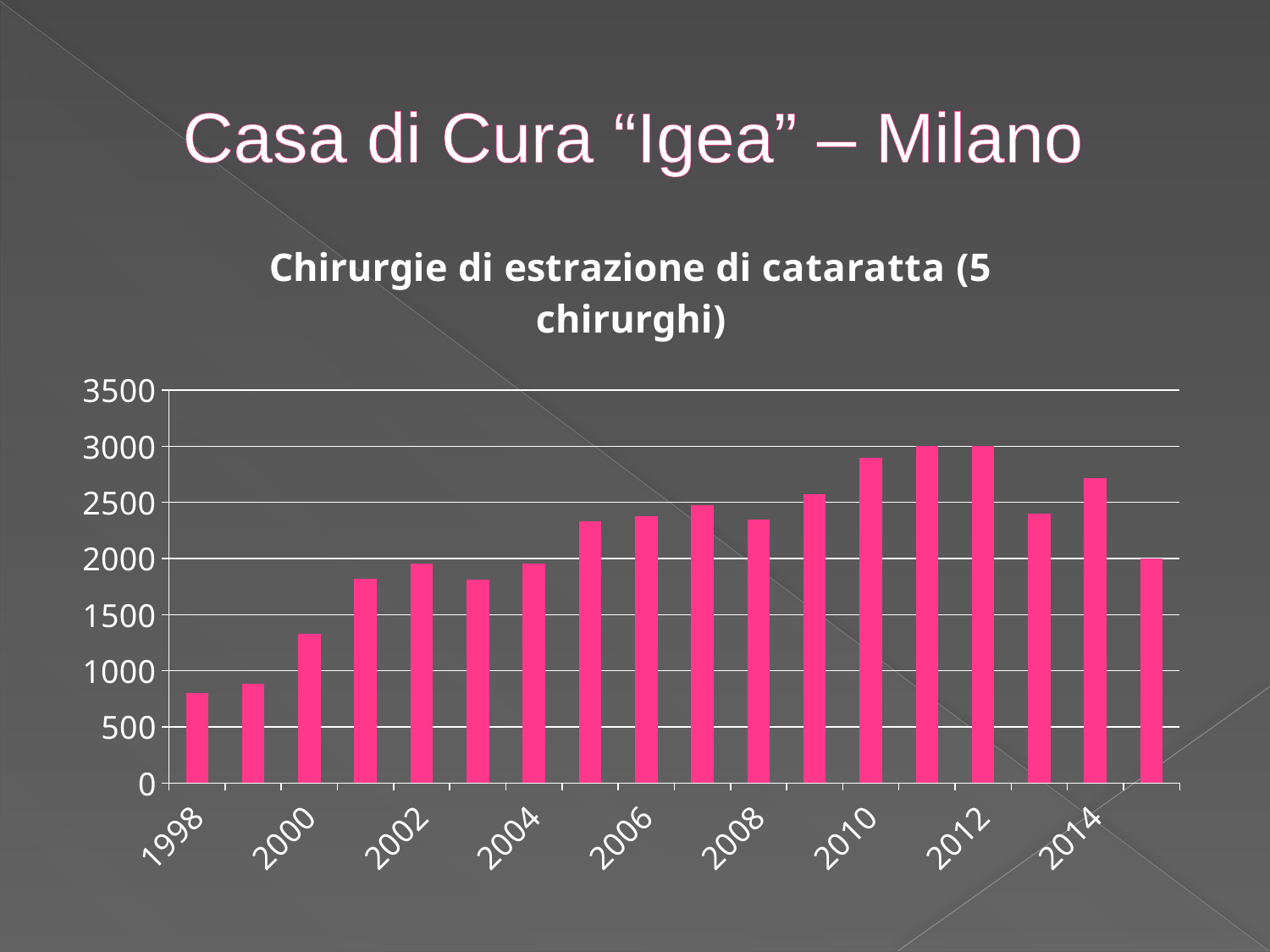
Is the value for 2010 greater or less than 2500? greater Is the value for 2008 greater or less than 2000? greater Is the value for 2014 greater or less than 2500? greater Which year has the larger value, 2000 or 2010? 2010 What kind of chart is shown on the slide? bar chart Which year has the larger value, 2013 or 2014? 2014 What is the title of the chart? Chirurgie di estrazione di cataratta (5 chirurghi) How many bars (years) are plotted in the chart? 18 Do the values generally rise or fall from 1998 to 2012? rise